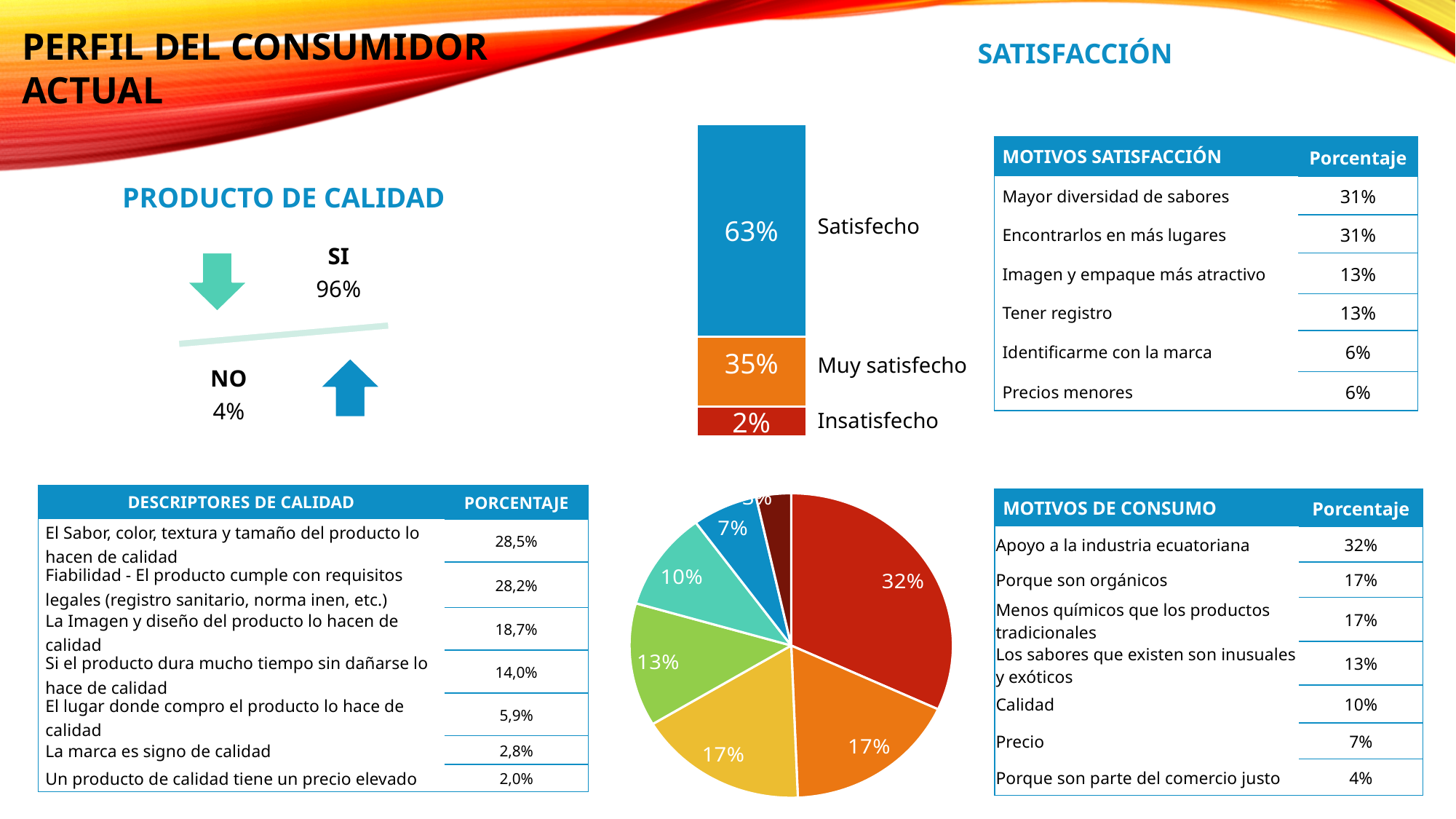
What kind of chart is shown at the bottom centre of the slide? Pie chart In the stacked bar chart under SATISFACCIÓN, which category has the largest segment? Satisfecho In the stacked bar chart under SATISFACCIÓN, which category has the smallest segment? Insatisfecho In the stacked bar chart under SATISFACCIÓN, what percentage is labelled Insatisfecho? 2% What kind of chart is shown under the SATISFACCIÓN heading? Stacked bar chart In the pie chart at the bottom centre of the slide, how many slices are there? 7 In the stacked bar chart under SATISFACCIÓN, how many segments make up the bar? 3 In the pie chart at the bottom centre of the slide, what is the percentage of the largest slice? 32% In the stacked bar chart under SATISFACCIÓN, what is the total of the three segments? 100% In the stacked bar chart under SATISFACCIÓN, what percentage is labelled Muy satisfecho? 35% In the stacked bar chart under SATISFACCIÓN, what is the difference between the Satisfecho and Muy satisfecho percentages? 28% In the stacked bar chart under SATISFACCIÓN, what percentage is labelled Satisfecho? 63%